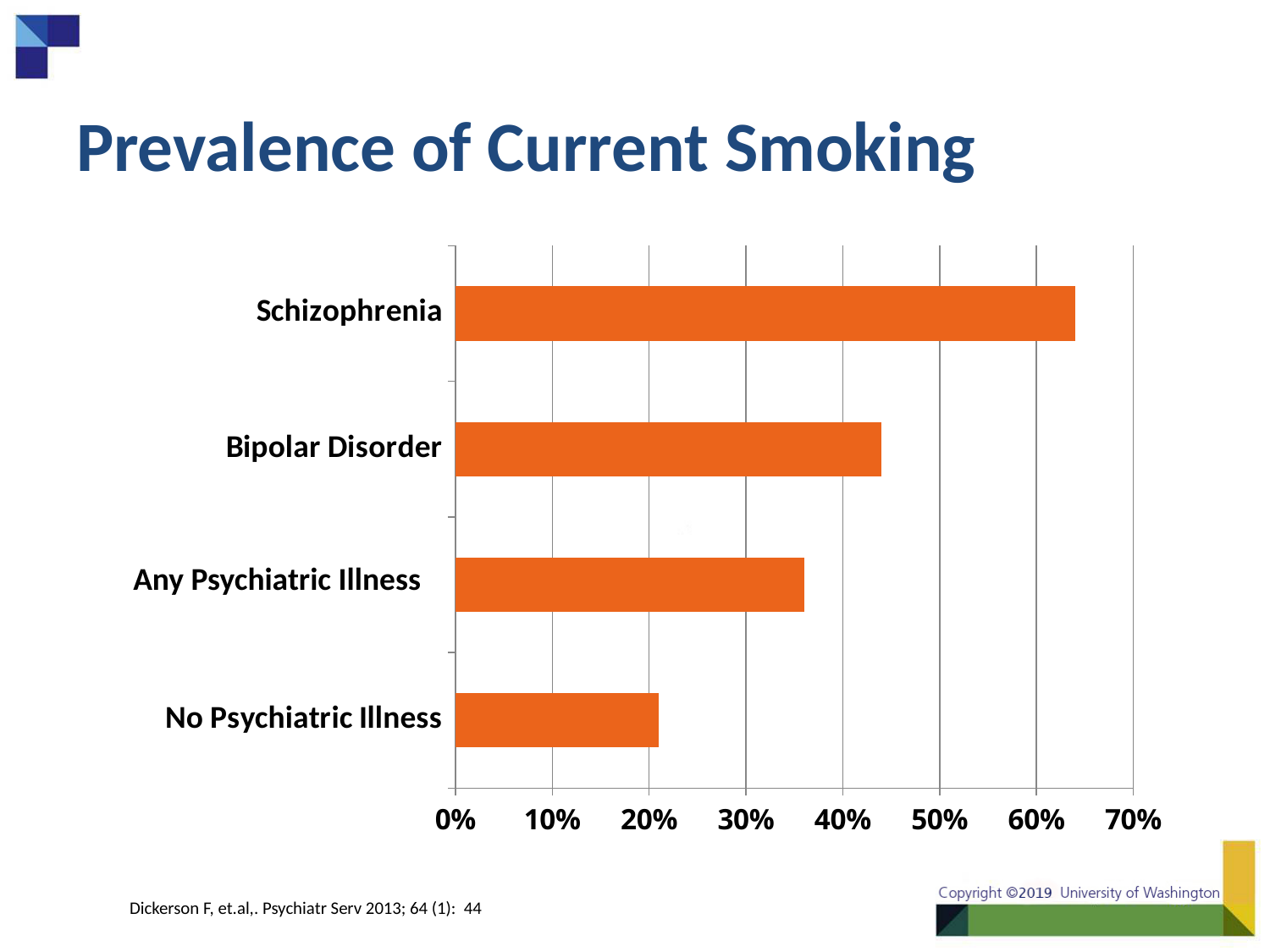
Is the value for Any Psychiatric Illness greater or less than 40%? less Is the value for No Psychiatric Illness greater or less than 30%? less Is the value for Schizophrenia greater or less than 60%? greater What is the highest value shown on the x axis of the chart? 70% Which is larger, the value for No Psychiatric Illness or the value for Schizophrenia? Schizophrenia How many categories are shown in the chart? 4 Which category has the lowest prevalence of current smoking? No Psychiatric Illness Which is larger, the value for Bipolar Disorder or the value for Any Psychiatric Illness? Bipolar Disorder What is the title of the chart on the slide? Prevalence of Current Smoking What kind of chart is shown on the slide? bar chart Which category has the highest prevalence of current smoking? Schizophrenia